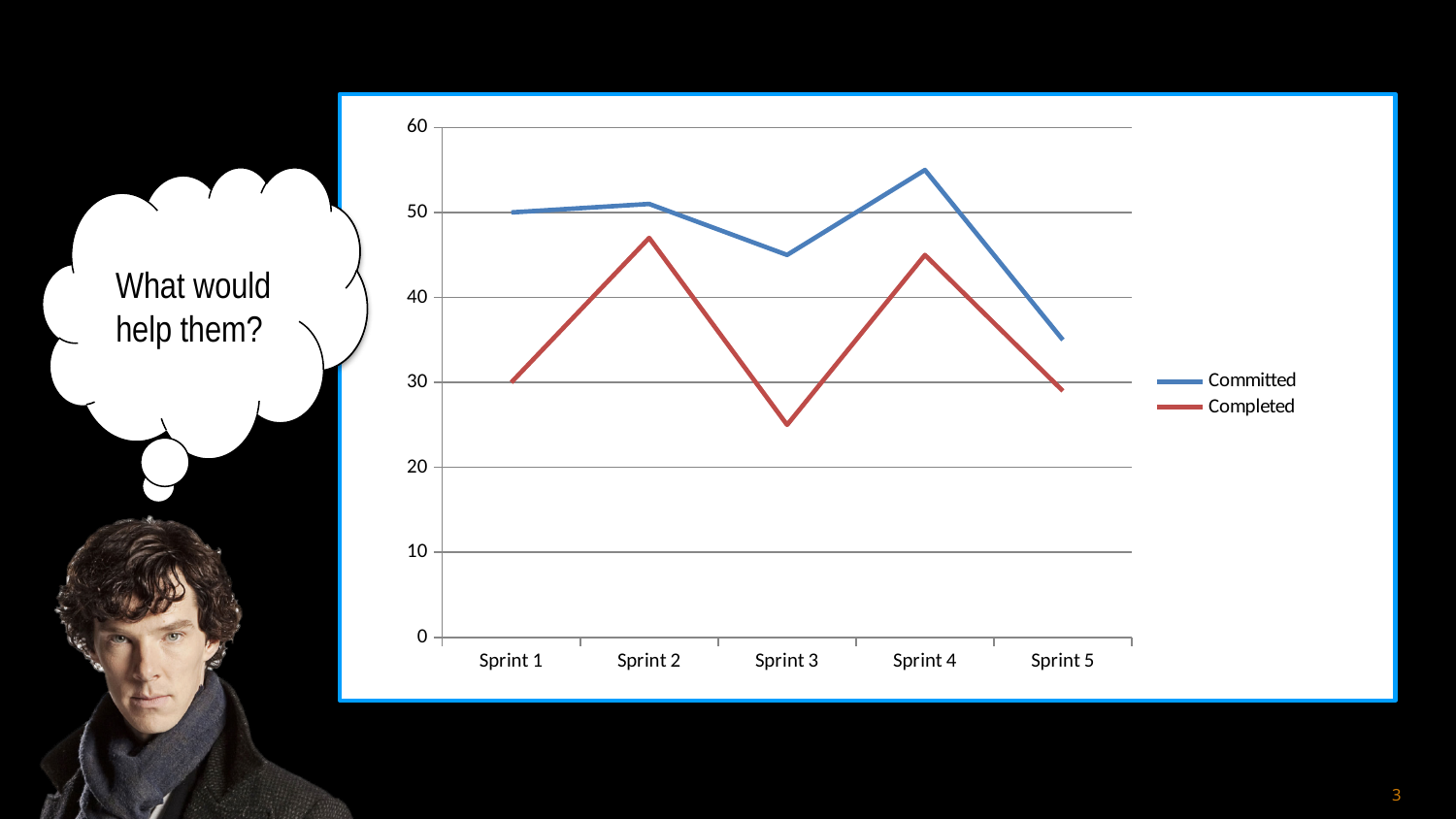
Which series is drawn in red on the chart? Completed In which sprint is the Completed value lowest? Sprint 3 How many sprints are shown on the x axis of the chart? 5 In which sprint is the Committed value highest? Sprint 4 Is the Committed value for Sprint 4 greater or less than 50? greater What are the two series named in the chart's legend? Committed and Completed What type of chart is shown on the slide? line chart In which sprint is the Committed value lowest? Sprint 5 How many series does the chart's legend list? 2 In Sprint 3, which is larger, the Committed value or the Completed value? Committed Does the Completed line rise or fall from Sprint 4 to Sprint 5? fall Is the Completed value for Sprint 3 greater or less than 30? less